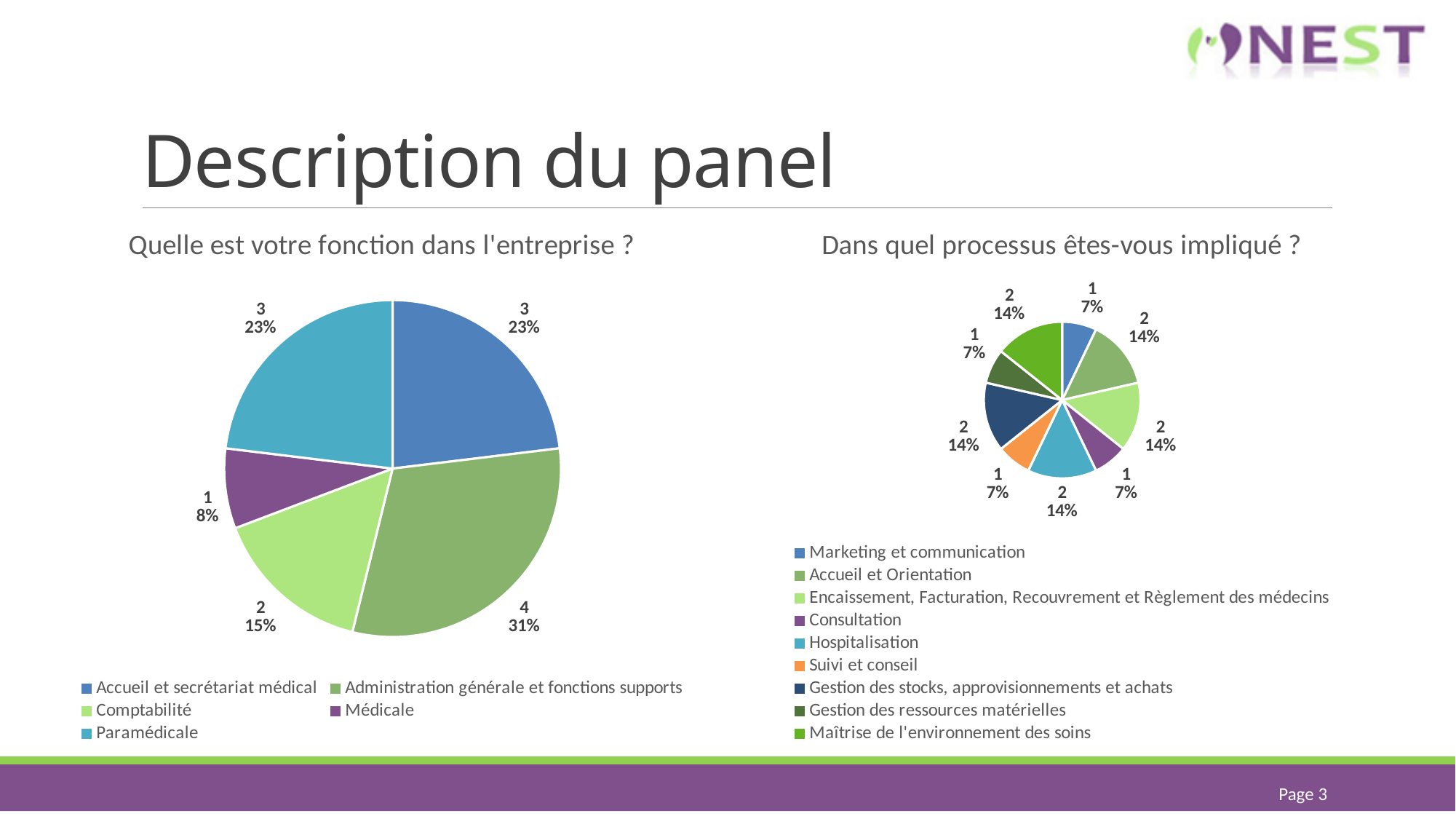
In the chart 'Dans quel processus êtes-vous impliqué ?', which is larger, 'Accueil et Orientation' or 'Suivi et conseil'? Accueil et Orientation In the chart 'Dans quel processus êtes-vous impliqué ?', how many categories does the legend list? 9 In the chart 'Dans quel processus êtes-vous impliqué ?', what colour is the 'Suivi et conseil' slice? orange In the chart 'Quelle est votre fonction dans l'entreprise ?', how many respondents are in 'Administration générale et fonctions supports'? 4 In the chart 'Quelle est votre fonction dans l'entreprise ?', which category has the largest slice? Administration générale et fonctions supports In the chart 'Dans quel processus êtes-vous impliqué ?', how many respondents are in 'Consultation'? 1 In the chart 'Quelle est votre fonction dans l'entreprise ?', what share of the pie is 'Médicale'? 8% In the chart 'Quelle est votre fonction dans l'entreprise ?', what kind of chart is shown? pie chart In the chart 'Quelle est votre fonction dans l'entreprise ?', how many categories does the legend list? 5 In the chart 'Quelle est votre fonction dans l'entreprise ?', what is the difference in count between 'Administration générale et fonctions supports' and 'Comptabilité'? 2 In the chart 'Dans quel processus êtes-vous impliqué ?', what share of the pie is 'Hospitalisation'? 14% In the chart 'Quelle est votre fonction dans l'entreprise ?', which category has the smallest slice? Médicale